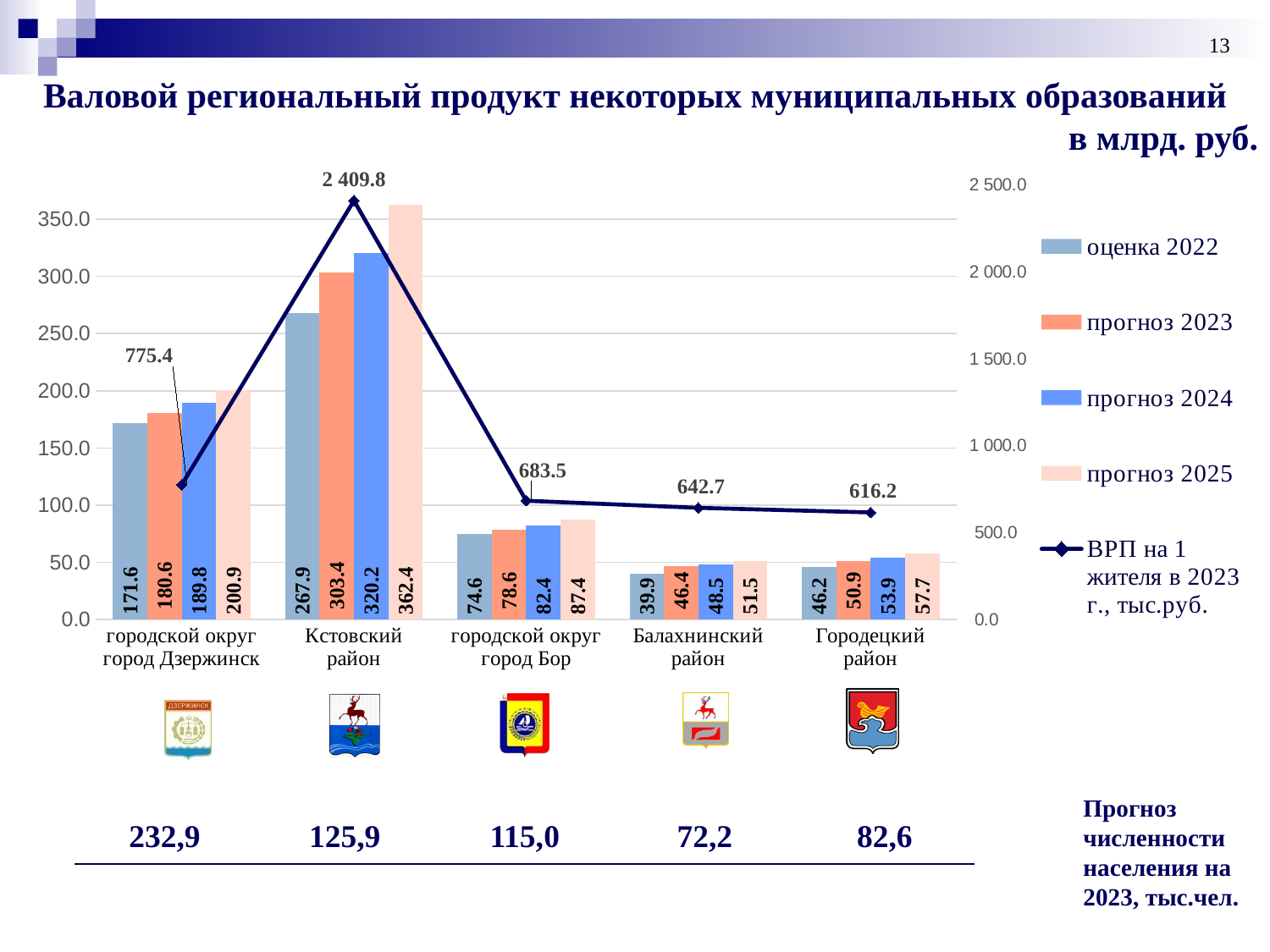
How many series does the legend list? 5 What is the оценка 2022 value for городской округ город Бор? 74.6 Which is larger: the прогноз 2023 value for Городецкий район or for Балахнинский район? Городецкий район Do the bar values for Городецкий район rise or fall from оценка 2022 to прогноз 2025? rise How many categories are shown on the x axis? 5 Is the прогноз 2024 value for Кстовский район greater or less than 300.0? greater What is the ВРП на 1 жителя в 2023 г. value for Балахнинский район? 642.7 What is the unit stated in the chart title? млрд. руб. Which category has the lowest оценка 2022 value? Балахнинский район What is the прогноз 2025 value for Кстовский район? 362.4 What is the difference between the прогноз 2025 and оценка 2022 values for городской округ город Дзержинск? 29.3 Which category has the highest прогноз 2024 value? Кстовский район